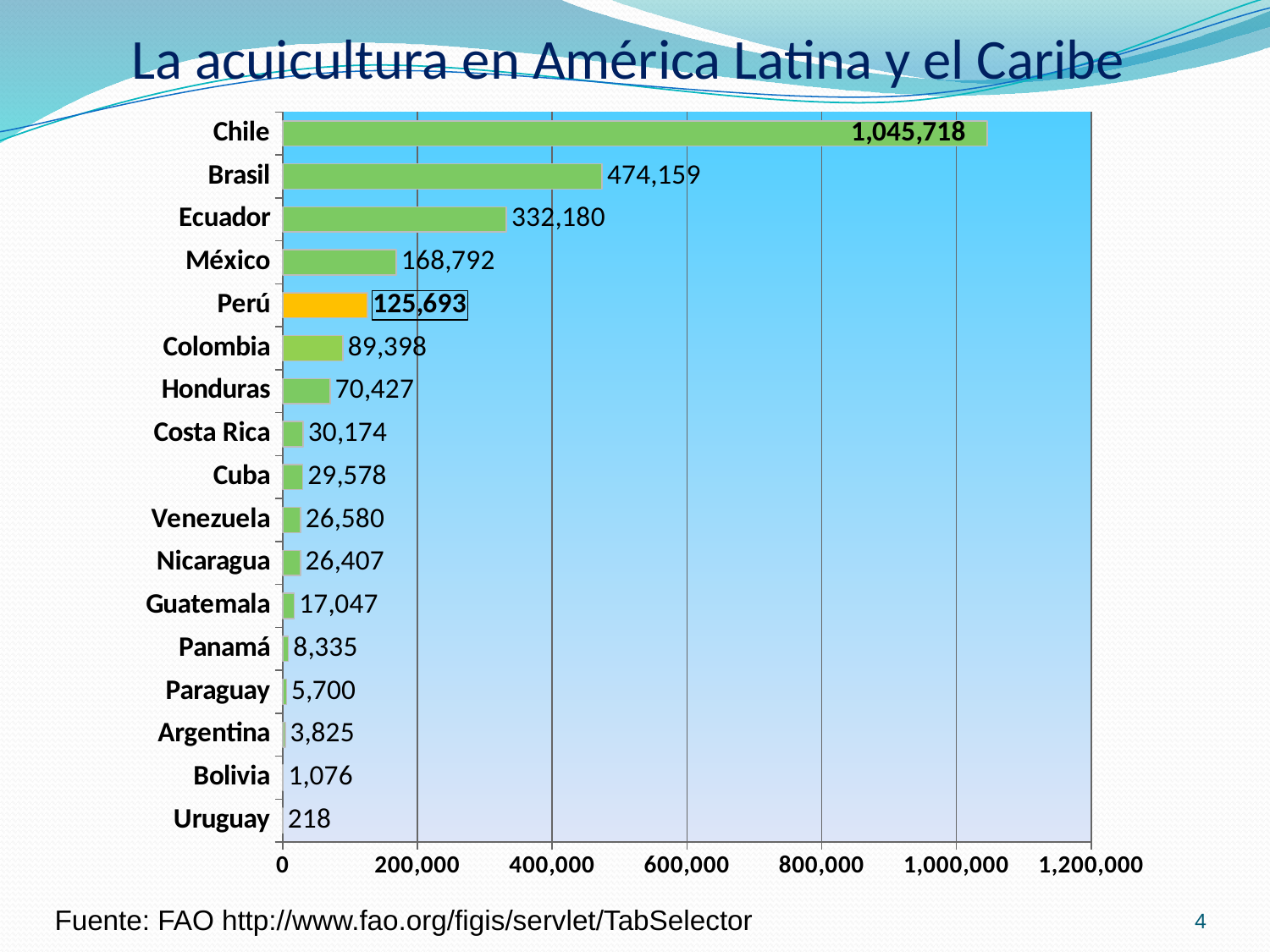
What is the difference between the values for Brasil and Ecuador? 141,979 What is the value for Chile? 1,045,718 What is the difference between the values for Costa Rica and Cuba? 596 How many countries are shown in the chart? 17 Is the value for Brasil greater or less than 400,000? greater Which country has the highest value? Chile What is the value for Perú? 125,693 Which country has the lowest value? Uruguay Which has a larger value, México or Colombia? México Which country's bar is highlighted in a different colour (orange) from the others? Perú What kind of chart is shown on the slide? bar chart What is the value for Honduras? 70,427